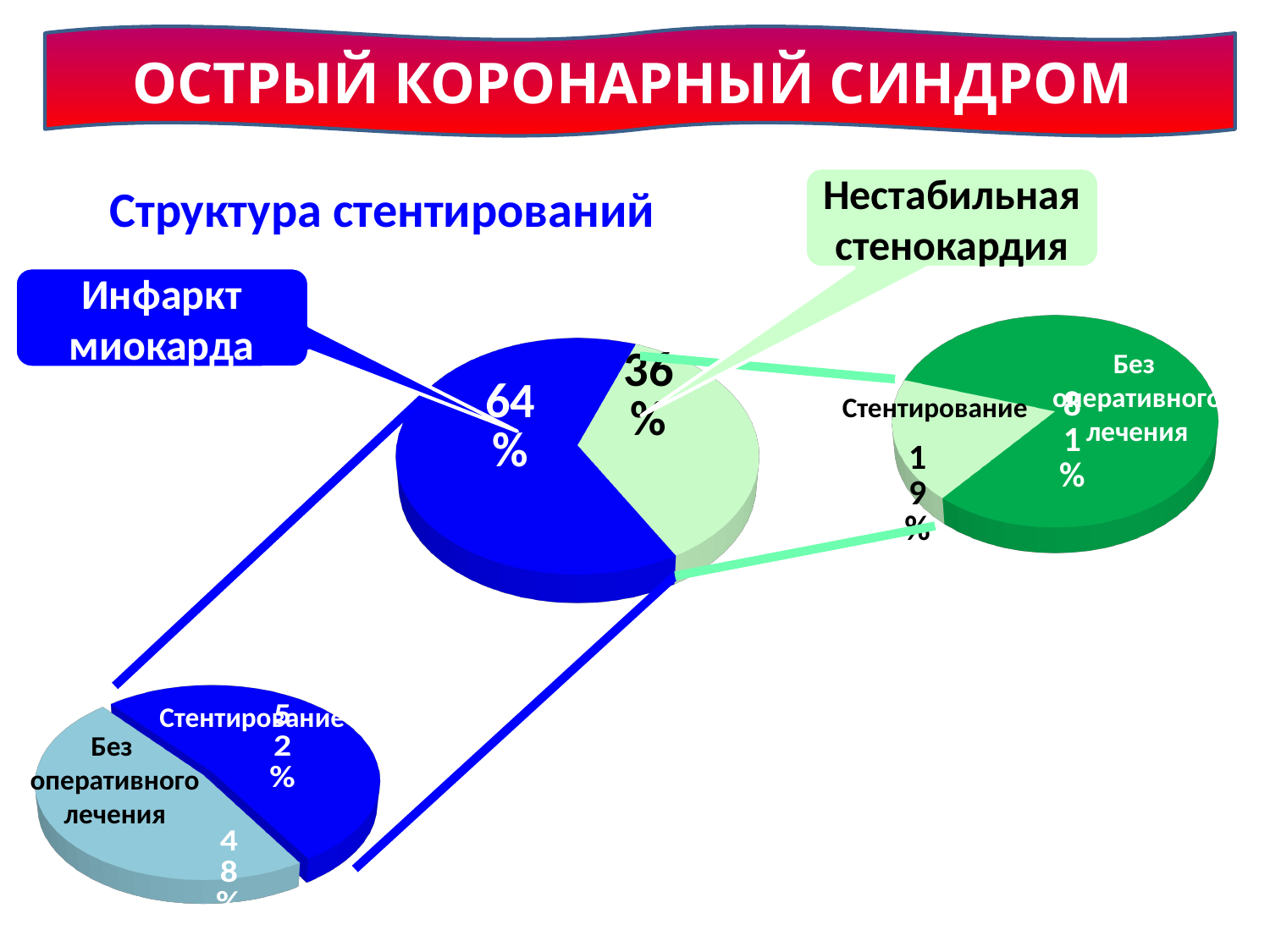
In the bottom-left pie chart, what share is labelled for 'Без оперативного лечения'? 48% What type of chart is the central chart 'Структура стентирований'? pie chart In the central pie chart 'Структура стентирований', what is the difference between the 'Инфаркт миокарда' and 'Нестабильная стенокардия' shares? 28% In the central pie chart 'Структура стентирований', which category has the larger slice? Инфаркт миокарда How many pie charts are shown on the slide? 3 Which is larger: the 'Стентирование' share in the bottom-left pie chart or the 'Стентирование' share in the right pie chart? bottom-left pie chart In the central pie chart 'Структура стентирований', what share is labelled for 'Инфаркт миокарда'? 64% In the right pie chart, what share is labelled for 'Без оперативного лечения'? 81% In the right pie chart, what share is labelled for 'Стентирование'? 19% In the right pie chart, which category has the smaller slice? Стентирование In the bottom-left pie chart, what share is labelled for 'Стентирование'? 52% In the central pie chart 'Структура стентирований', what share is labelled for 'Нестабильная стенокардия'? 36%